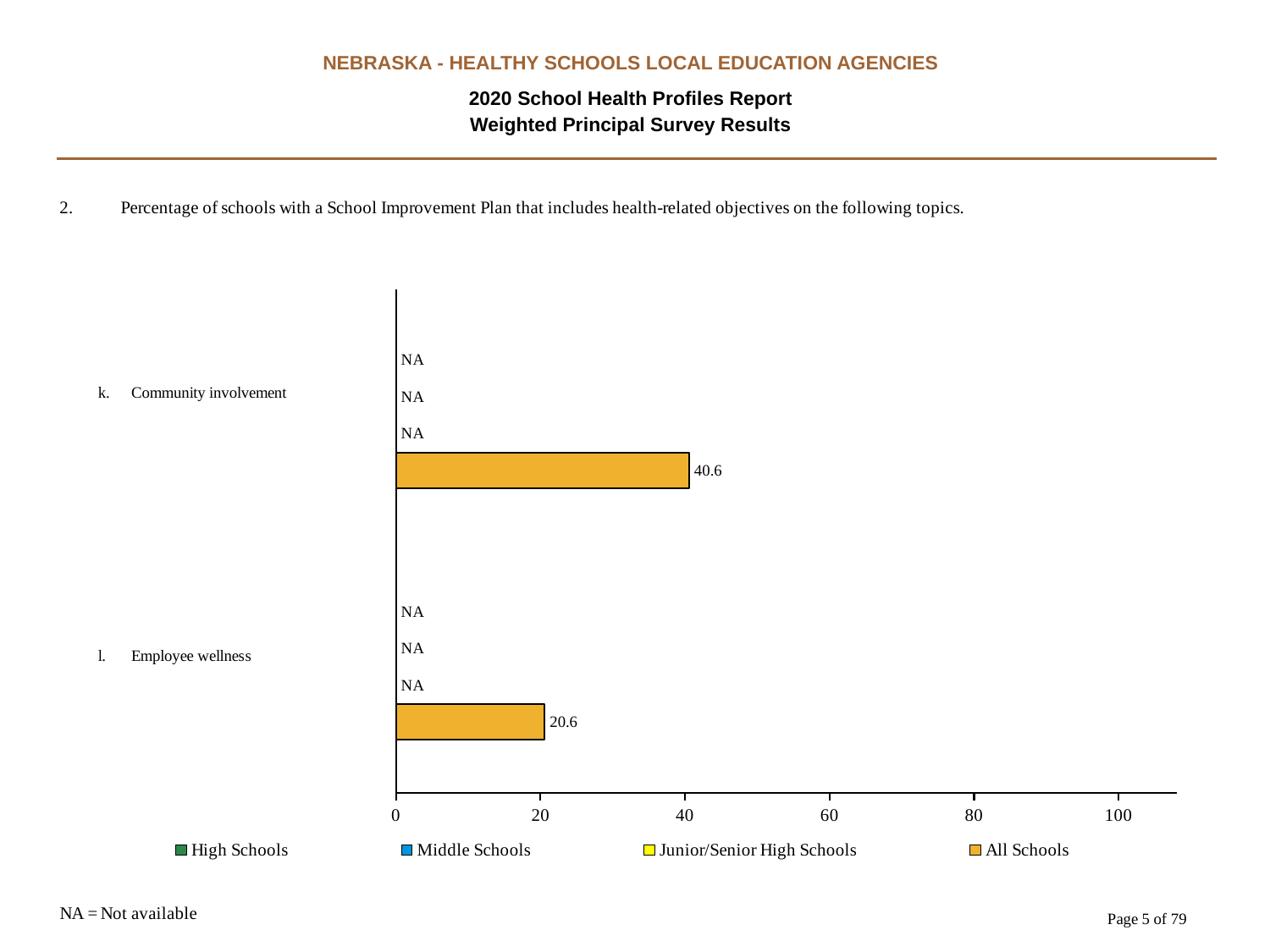
Which topic has the lowest All Schools value? Employee wellness How many series does the legend list? 4 What kind of chart is shown on the slide? bar chart Is the All Schools value for Community involvement greater or less than 40? greater What is the maximum value shown on the x axis? 100 How many topics are shown on the chart? 2 What is the All Schools value for Community involvement? 40.6 Which topic has the higher All Schools value, Community involvement or Employee wellness? Community involvement What value is shown for High Schools for Employee wellness? NA What is the difference between the All Schools values for Community involvement and Employee wellness? 20.0 Which legend entry corresponds to the bars that have plotted values? All Schools What is the All Schools value for Employee wellness? 20.6